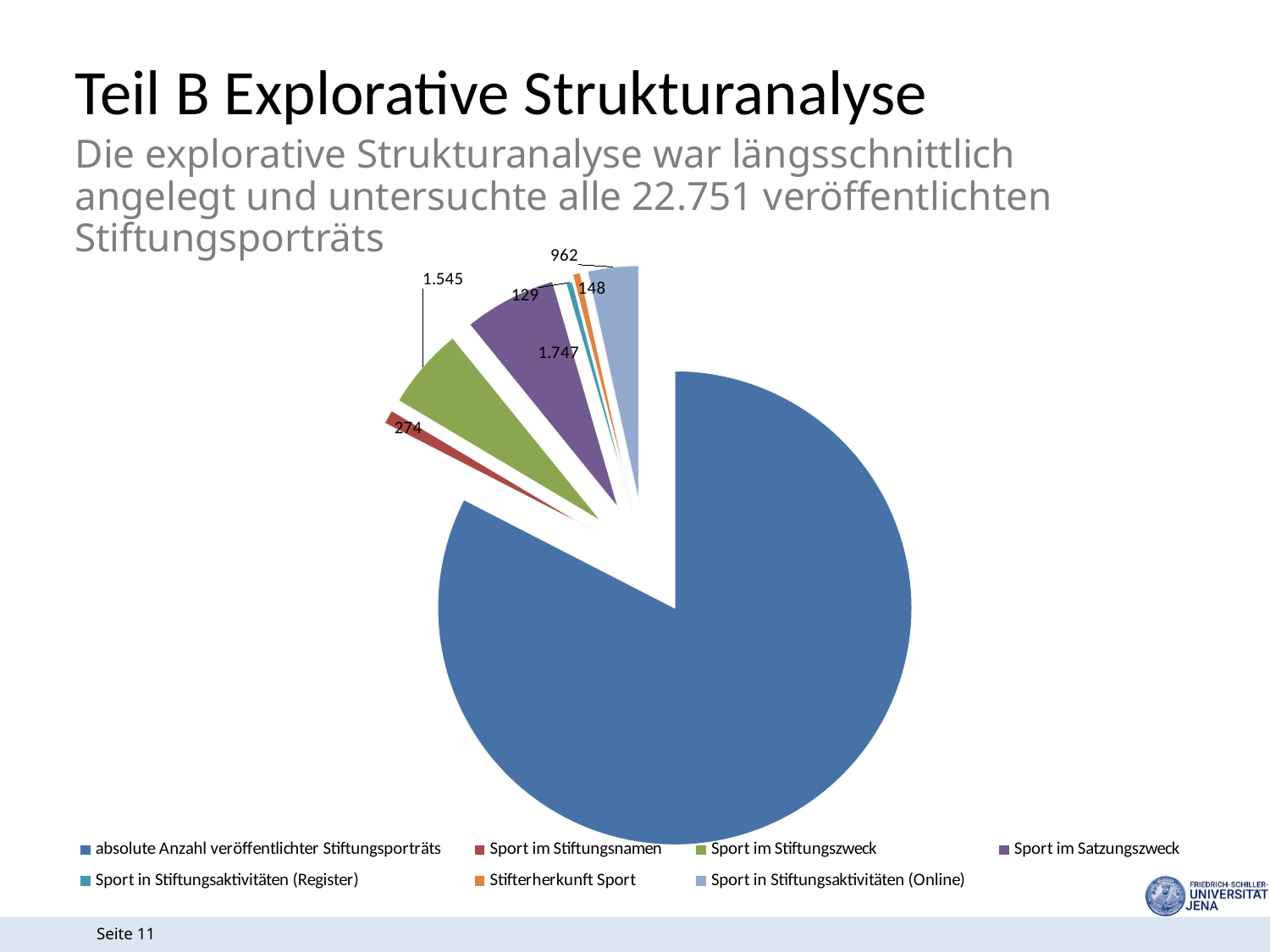
What value is shown for the slice 'Sport in Stiftungsaktivitäten (Online)'? 962 What is the difference between the values for 'Sport im Satzungszweck' and 'Sport im Stiftungszweck'? 202 What colour is the largest slice of the pie? blue What value is shown for the slice 'Sport im Stiftungszweck'? 1.545 Which is larger: the value for 'Sport im Satzungszweck' or for 'Sport im Stiftungszweck'? Sport im Satzungszweck How many entries does the chart legend list? 7 What value is shown for the slice 'Stifterherkunft Sport'? 148 What value is shown for the slice 'Sport in Stiftungsaktivitäten (Register)'? 129 What kind of chart is shown on the slide? pie chart What value is shown for the slice 'Sport im Stiftungsnamen'? 274 Which legend category has the largest slice of the pie? absolute Anzahl veröffentlichter Stiftungsporträts What value is shown for the slice 'Sport im Satzungszweck'? 1.747